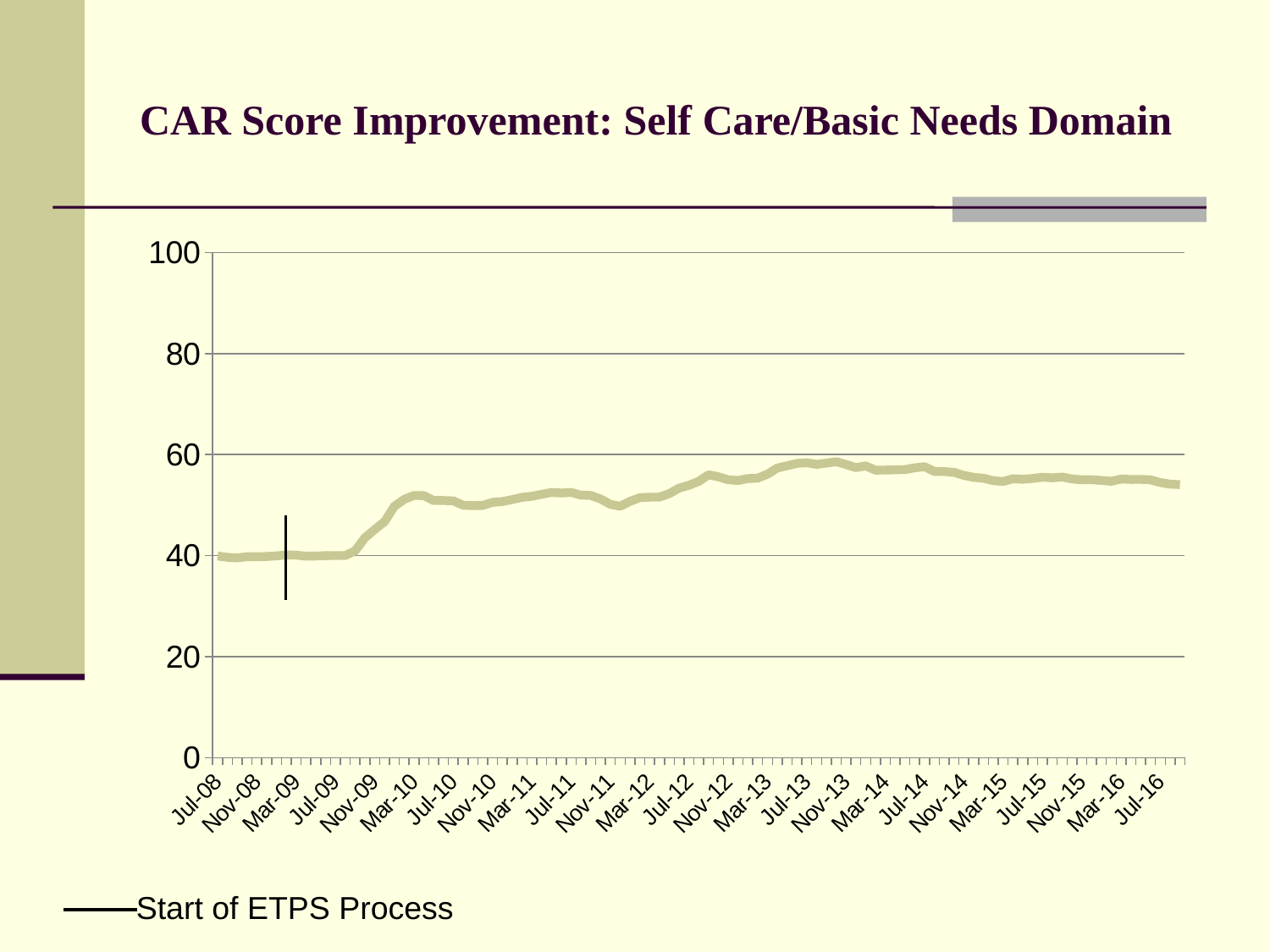
Which is larger, the value for Jul-09 or the value for Nov-13? Nov-13 What entry does the legend below the chart list? Start of ETPS Process Is the value for Jul-16 greater or less than 40? greater Is the value for Jul-08 greater or less than 60? less What is the title of the chart? CAR Score Improvement: Self Care/Basic Needs Domain What kind of chart is shown on the slide? line chart Is the value for Mar-10 greater or less than 40? greater Overall, does the line rise or fall from Jul-08 to Jul-16? rise Which is larger, the value for Jul-08 or the value for Jul-16? Jul-16